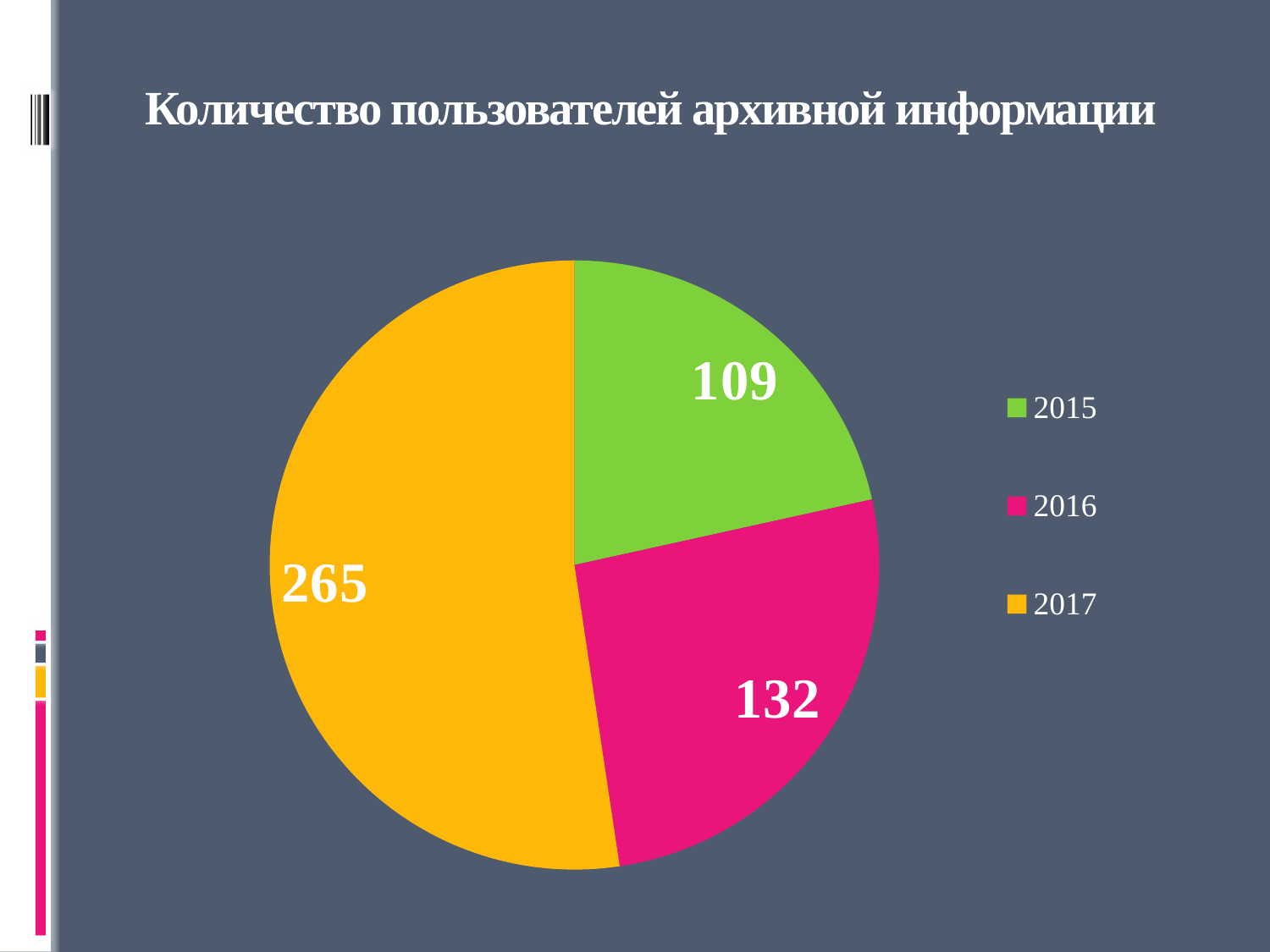
What is the difference between the values for 2016 and 2015? 23 What is the difference between the values for 2017 and 2016? 133 How many slices does the pie chart have? 3 What kind of chart is shown on the slide? pie chart Which year has the largest slice? 2017 Which year has the smallest slice? 2015 What is the value for 2015? 109 What is the title of the chart? Количество пользователей архивной информации What is the value for 2016? 132 Which is larger, the value for 2016 or the value for 2015? 2016 What is the value for 2017? 265 What is the total of all three slices? 506